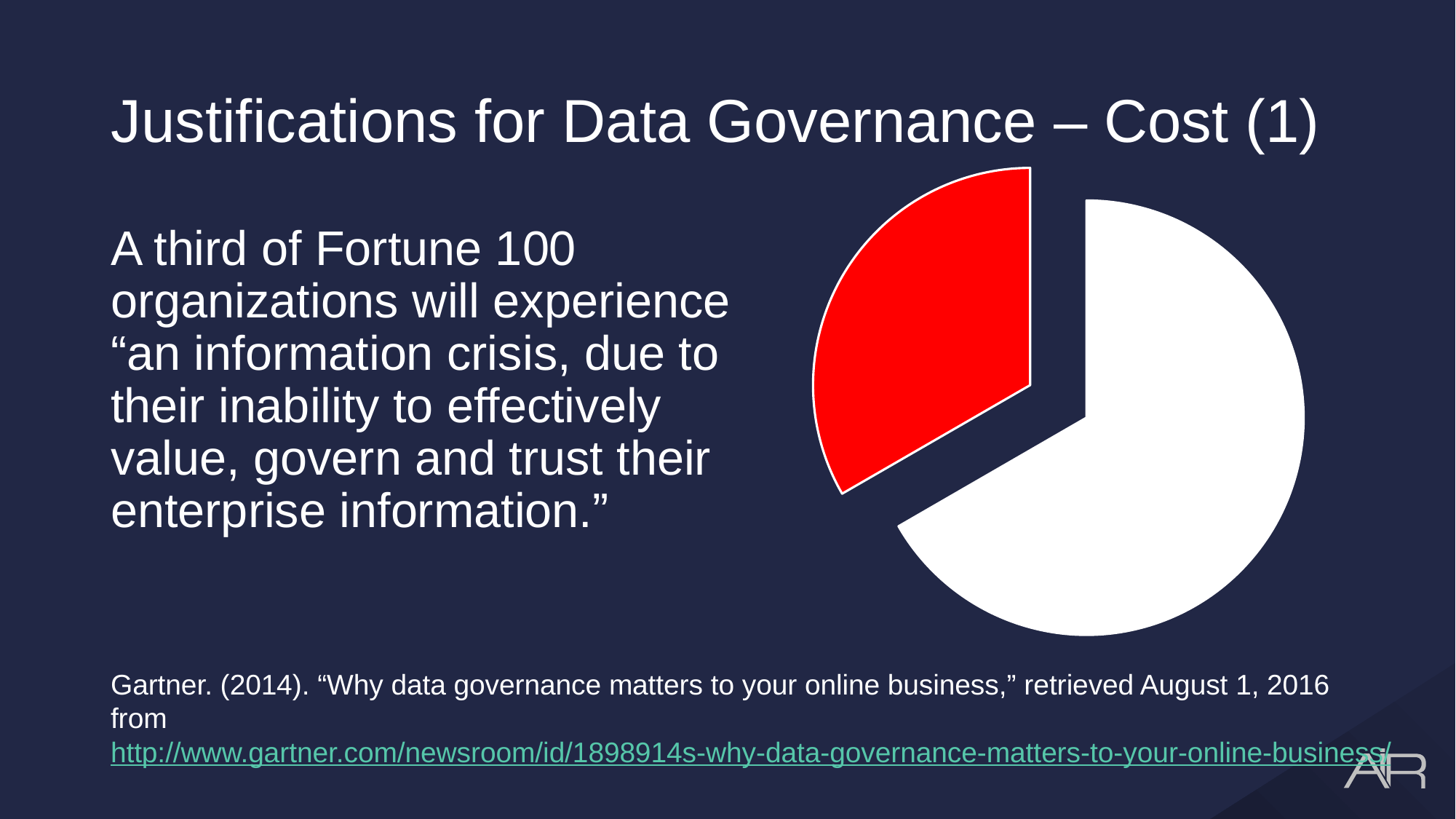
Which slice of the pie chart is the largest? the white slice Which slice of the pie chart is pulled out (exploded) from the rest of the pie? the red slice Which slice is larger, the red slice or the white slice? the white slice What colours are the two slices of the pie chart? red and white How many slices does the pie chart have? 2 What kind of chart is shown on the slide? pie chart Which slice of the pie chart is the smallest? the red slice